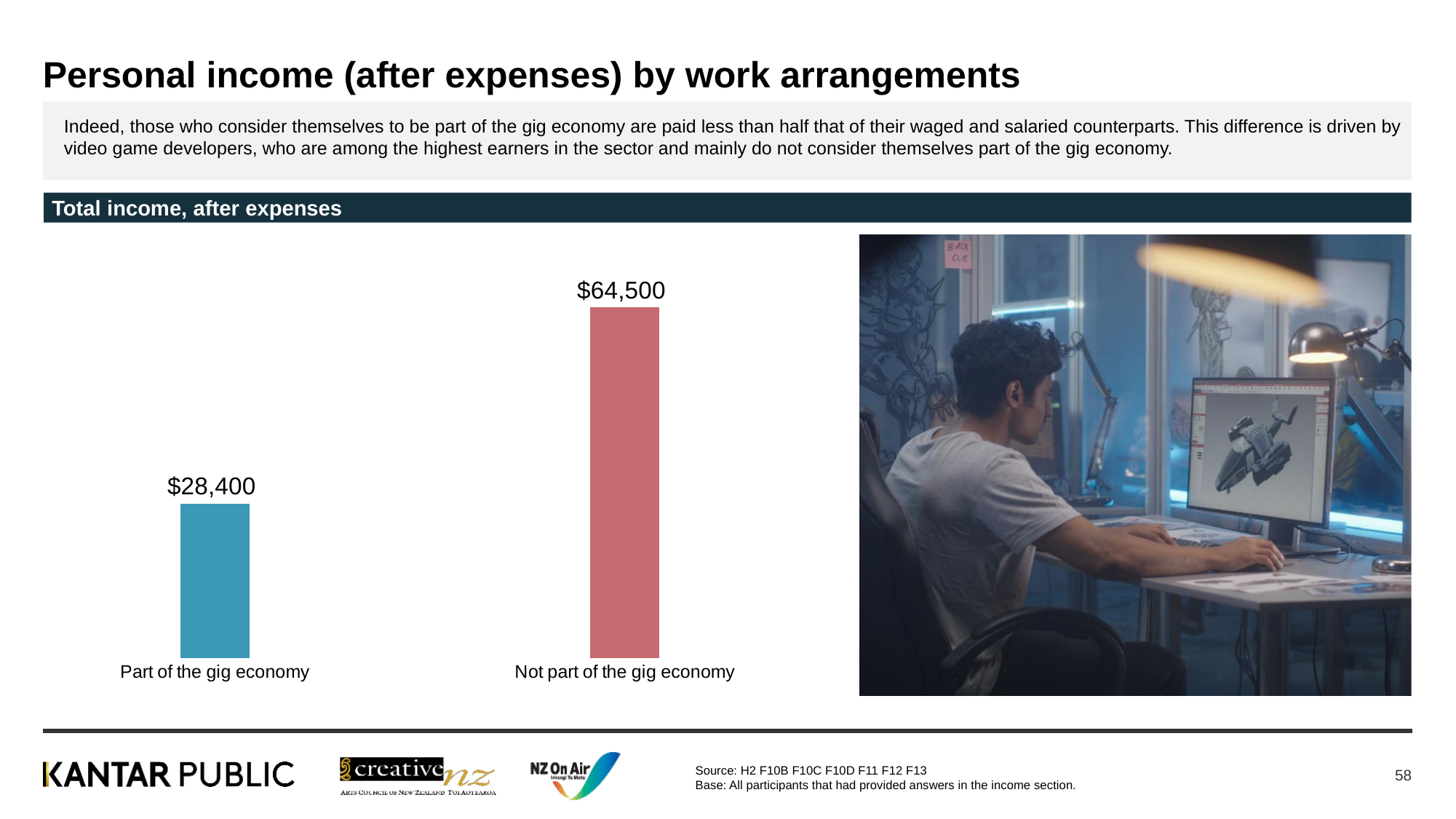
What colour is the bar for 'Part of the gig economy'? blue What kind of chart is shown on the slide? bar chart What is the title of the chart? Total income, after expenses Is the income for 'Part of the gig economy' larger or smaller than the income for 'Not part of the gig economy'? smaller Which category has the higher total income after expenses? Not part of the gig economy What is the difference in total income after expenses between those not part of the gig economy and those part of the gig economy? $36,100 Which category has the lower total income after expenses? Part of the gig economy What is the total income after expenses for those not part of the gig economy? $64,500 What is the total income after expenses for those who are part of the gig economy? $28,400 How many categories are shown in the chart? 2